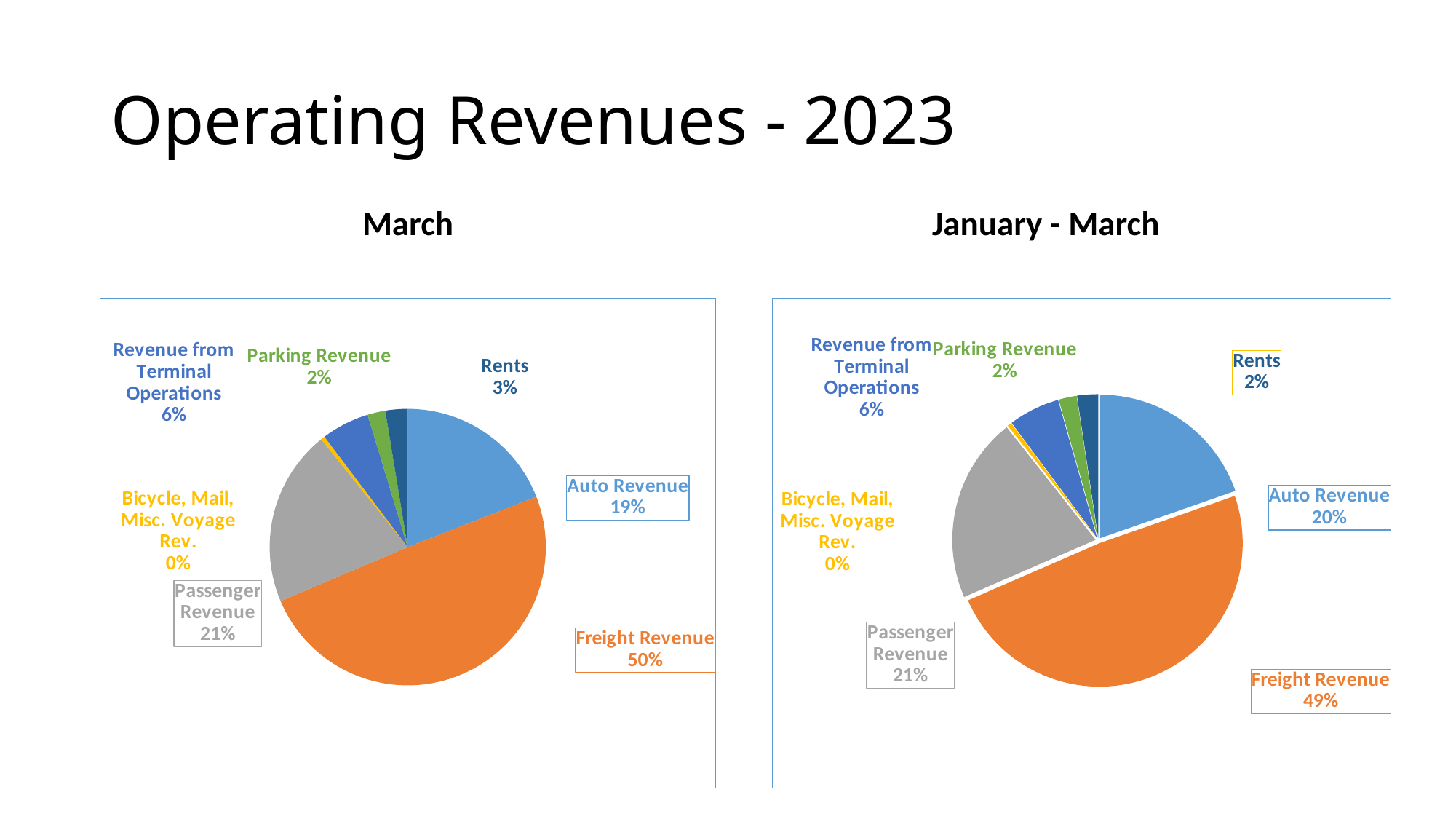
In the March chart, what share of operating revenues is Freight Revenue? 50% In the January - March chart, which is larger, Auto Revenue or Passenger Revenue? Passenger Revenue In the March chart, which category has the largest share? Freight Revenue In the January - March chart, what share of operating revenues is Auto Revenue? 20% In the January - March chart, which category has the smallest share? Bicycle, Mail, Misc. Voyage Rev. In the March chart, what share is Rents? 3% In the January - March chart, what is the combined share of Freight Revenue and Passenger Revenue? 70% How many categories are shown in the March pie chart? 7 In the March chart, what is the difference between the Freight Revenue share and the Passenger Revenue share? 29% What kind of chart is the January - March chart? Pie chart What is the title of the slide? Operating Revenues - 2023 In the January - March chart, what share is Revenue from Terminal Operations? 6%